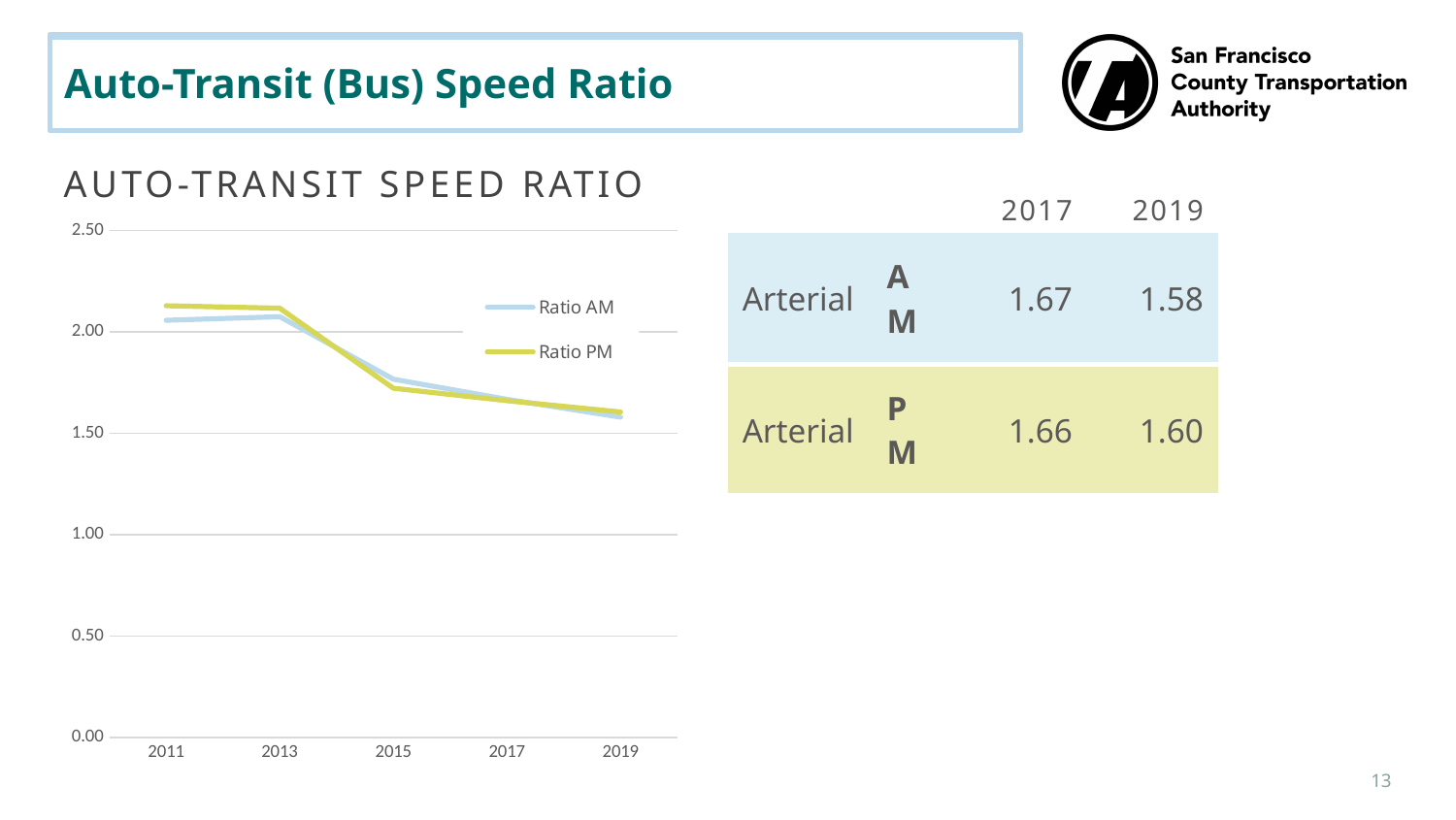
What kind of chart is shown on the slide? line chart Do the Ratio AM values rise or fall from 2011 to 2019? fall Is the Ratio PM value for 2017 greater or less than 2.00? less Do the Ratio PM values rise or fall from 2011 to 2019? fall Is the Ratio AM value for 2015 greater or less than 2.00? less Which year has the lowest Ratio AM value? 2019 How many years are shown along the x axis of the chart? 5 What is the title of the chart? AUTO-TRANSIT SPEED RATIO How many series does the chart legend list? 2 Which is larger, the Ratio AM value for 2011 or for 2019? 2011 Is the Ratio PM value for 2011 greater or less than 2.00? greater